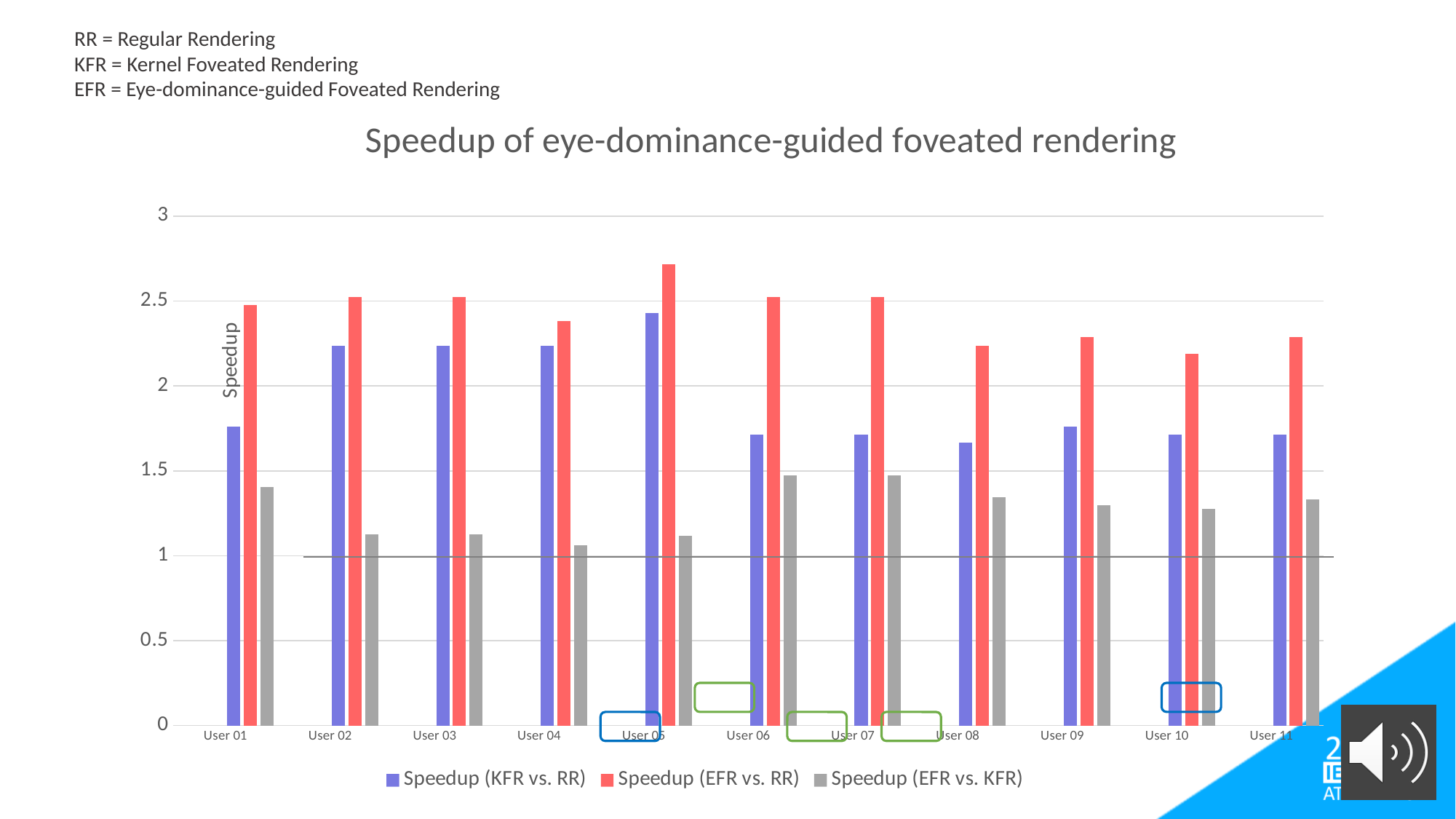
How many users (categories) are shown on the x axis? 11 Is the Speedup (EFR vs. KFR) for User 04 greater or less than 1.5? less Is the Speedup (KFR vs. RR) for User 01 greater or less than 2? less What is the label on the vertical axis? Speedup Is the Speedup (EFR vs. RR) for User 05 greater or less than 2.5? greater How many series does the legend list? 3 What is the title of the chart? Speedup of eye-dominance-guided foveated rendering Which user has the highest Speedup (KFR vs. RR)? User 05 Which is larger: the Speedup (KFR vs. RR) for User 02 or for User 06? User 02 Which is larger: the Speedup (EFR vs. KFR) for User 01 or for User 02? User 01 Which user has the highest Speedup (EFR vs. RR)? User 05 What kind of chart is shown on the slide? bar chart